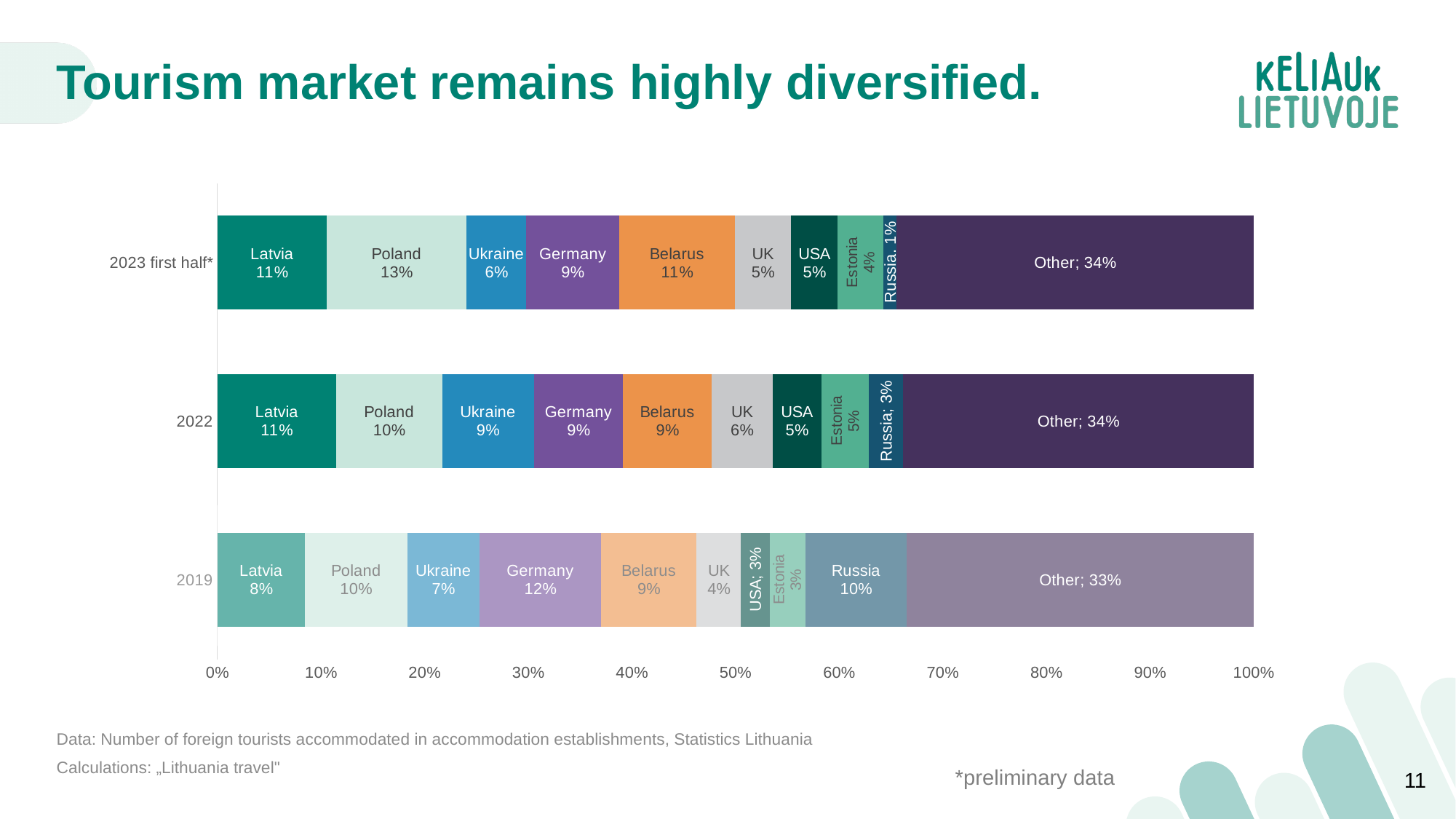
Excluding 'Other', which country has the largest share in the 2019 bar? Germany What share of foreign tourists came from Poland in the 2023 first half? 13% What share of foreign tourists came from Russia in 2019? 10% What is the share of 'Other' in the 2022 bar? 34% How many bars (time periods) does the chart show? 3 What kind of chart is shown on the slide? Stacked bar chart What is the share for Russia in the 2023 first half? 1% What share of foreign tourists came from Germany in 2022? 9% Which is larger: Ukraine's share in 2022 or Ukraine's share in the 2023 first half? 2022 Which country has the smallest share in the 2023 first half bar? Russia What is the difference between Poland's share in the 2023 first half and in 2022? 3 percentage points How did Russia's share change from 2019 to the 2023 first half? It fell from 10% to 1%